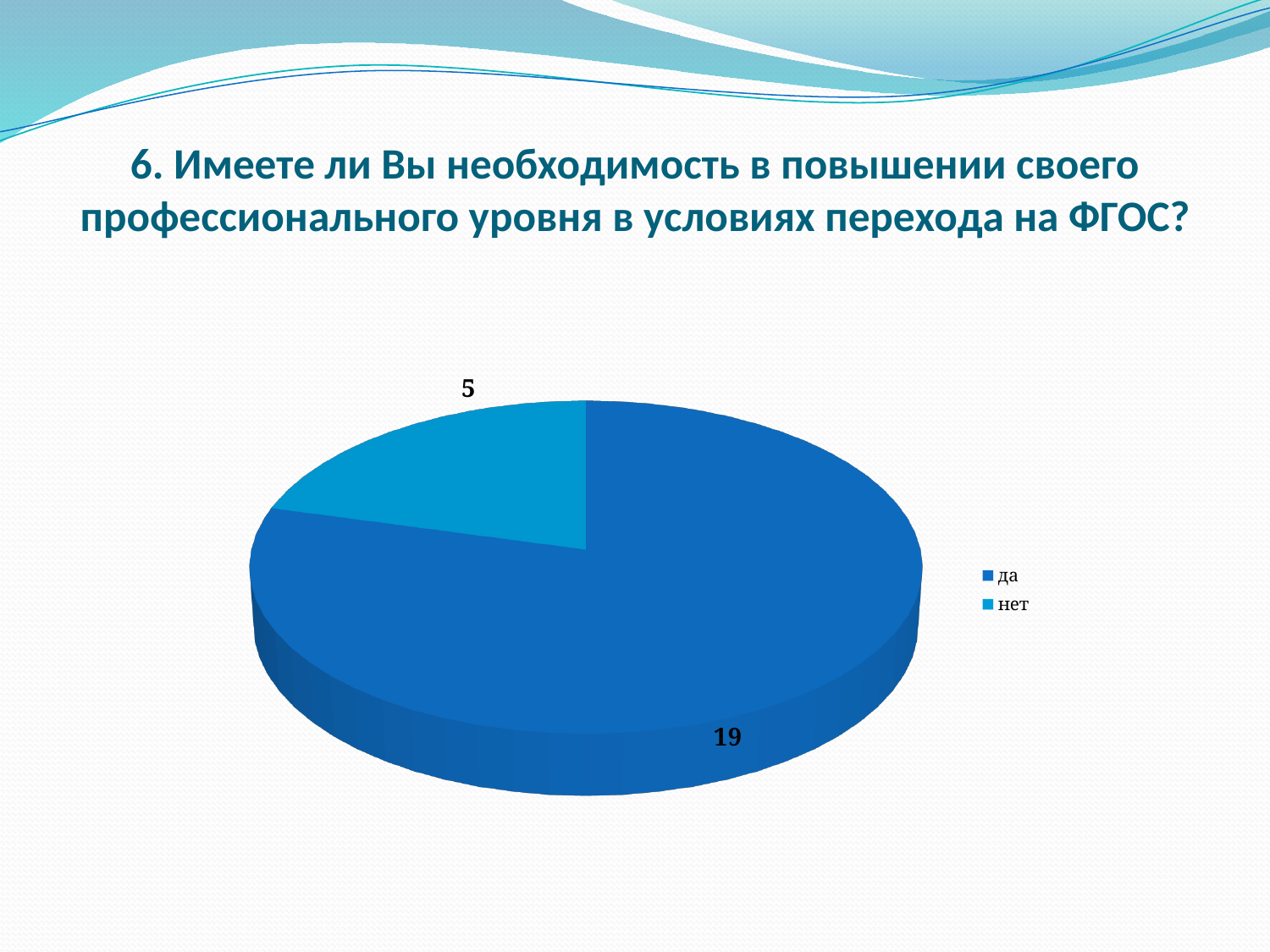
What is the difference between the "да" and "нет" values? 14 Which is larger, the value for "да" or the value for "нет"? да How many slices does the pie chart have? 2 What is the value for the "нет" slice? 5 Which slice is the smallest? нет What type of chart is shown on the slide? pie chart What is the total of all slices in the pie chart? 24 Which slice is the largest? да What is the value for the "да" slice? 19 What fraction of the total does the "нет" slice represent? 5 of 24 How many entries does the legend list? 2 Which legend entry is shown in the lighter blue colour? нет